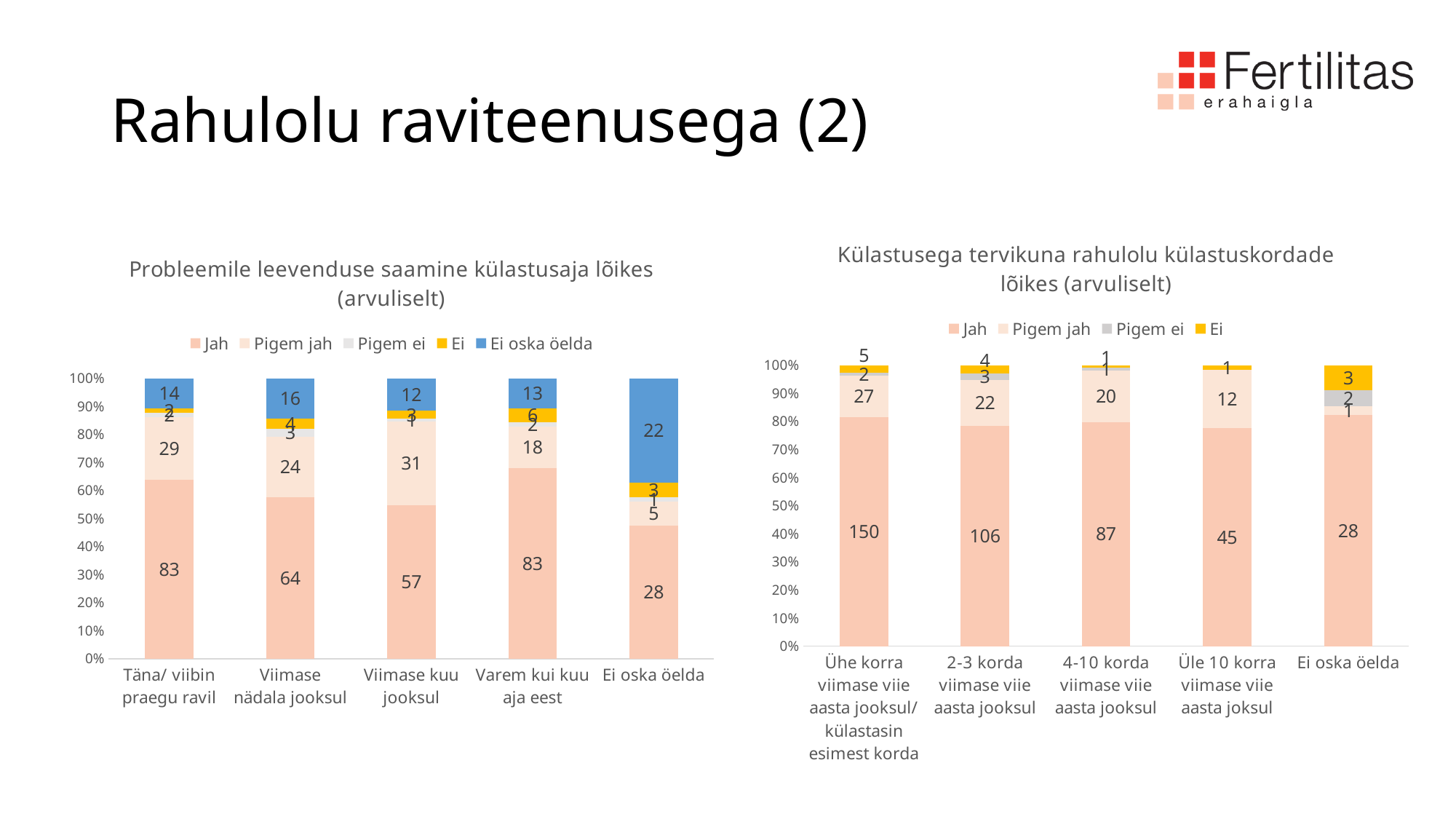
In the right chart (Külastusega tervikuna rahulolu külastuskordade lõikes), what is the Jah value for 2-3 korda viimase viie aasta jooksul? 106 In the left chart (Probleemile leevenduse saamine külastusaja lõikes), which category has the lowest Jah value? Ei oska öelda In the left chart (Probleemile leevenduse saamine külastusaja lõikes), what is the Jah value for Viimase nädala jooksul? 64 In the left chart (Probleemile leevenduse saamine külastusaja lõikes), what is the Ei oska öelda value for the Ei oska öelda category? 22 In the left chart (Probleemile leevenduse saamine külastusaja lõikes), what is the Pigem jah value for Viimase kuu jooksul? 31 In the right chart (Külastusega tervikuna rahulolu külastuskordade lõikes), which category has the highest Jah value? Ühe korra viimase viie aasta jooksul/ külastasin esimest korda What kind of chart is the right chart (Külastusega tervikuna rahulolu külastuskordade lõikes)? Stacked bar chart In the right chart (Külastusega tervikuna rahulolu külastuskordade lõikes), which is larger: the Jah value for 4-10 korda viimase viie aasta jooksul or for Üle 10 korra viimase viie aasta joksul? 4-10 korda viimase viie aasta jooksul In the right chart (Külastusega tervikuna rahulolu külastuskordade lõikes), how many categories are shown on the x axis? 5 In the left chart (Probleemile leevenduse saamine külastusaja lõikes), how many series does the legend list? 5 In the left chart (Probleemile leevenduse saamine külastusaja lõikes), what is the difference between the Pigem jah values for Täna/ viibin praegu ravil and Varem kui kuu aja eest? 11 In the right chart (Külastusega tervikuna rahulolu külastuskordade lõikes), what is the Pigem jah value for Üle 10 korra viimase viie aasta joksul? 12